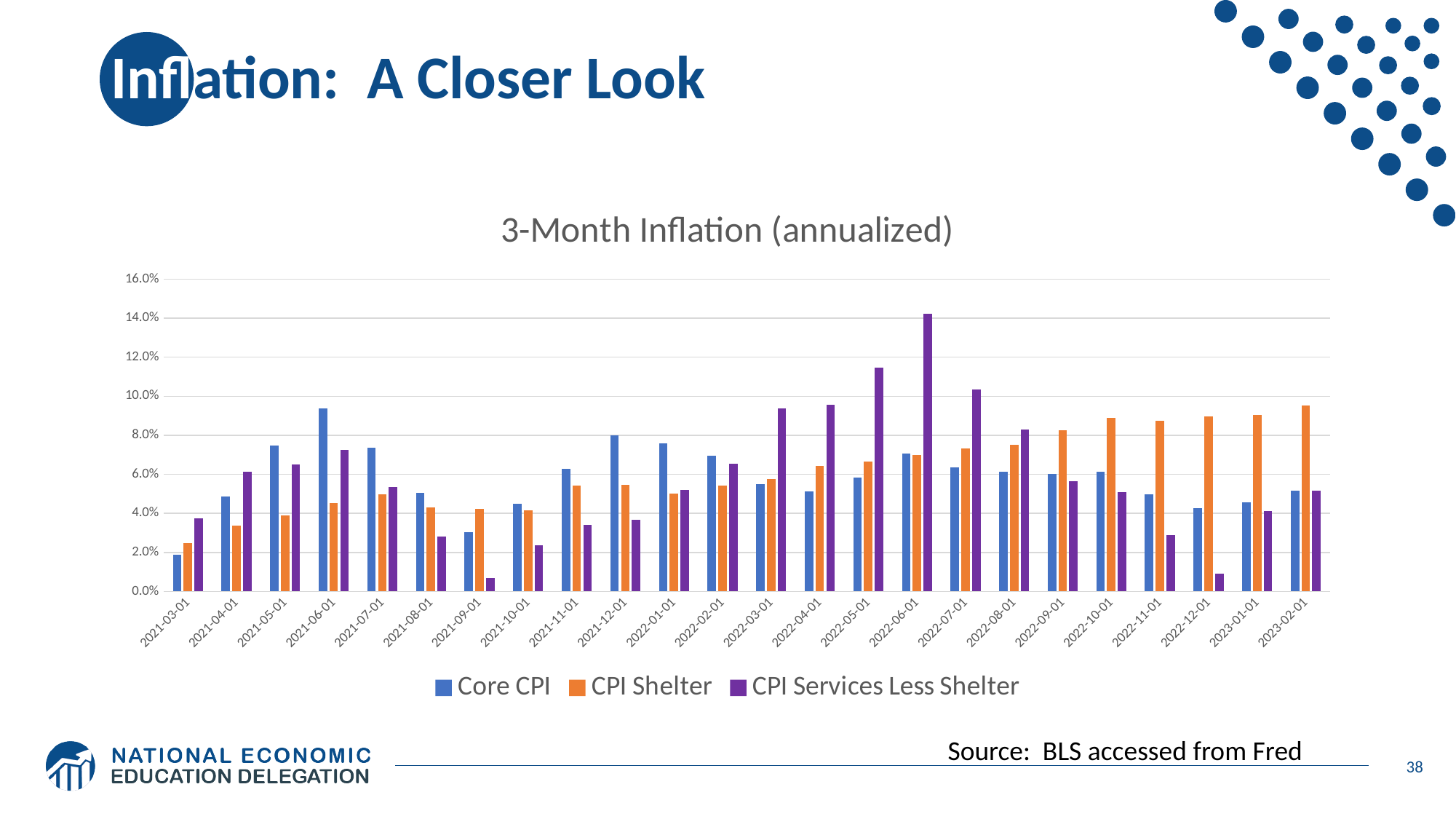
In 2022-12-01, which is larger: CPI Shelter or CPI Services Less Shelter? CPI Shelter In which month is CPI Shelter at its lowest? 2021-03-01 What kind of chart is shown on the slide? Bar chart Does CPI Shelter generally rise or fall from 2021-03-01 to 2023-02-01? Rise In which month is Core CPI at its highest? 2021-06-01 What is the title of the chart? 3-Month Inflation (annualized) Is the value for CPI Services Less Shelter in 2022-06-01 greater or less than 12.0%? greater In which month does CPI Services Less Shelter reach its highest value? 2022-06-01 Is the value for Core CPI in 2021-06-01 greater or less than 8.0%? greater In which month is Core CPI at its lowest? 2021-03-01 How many months (categories) are shown on the x axis of the chart? 24 How many series does the chart legend list? 3